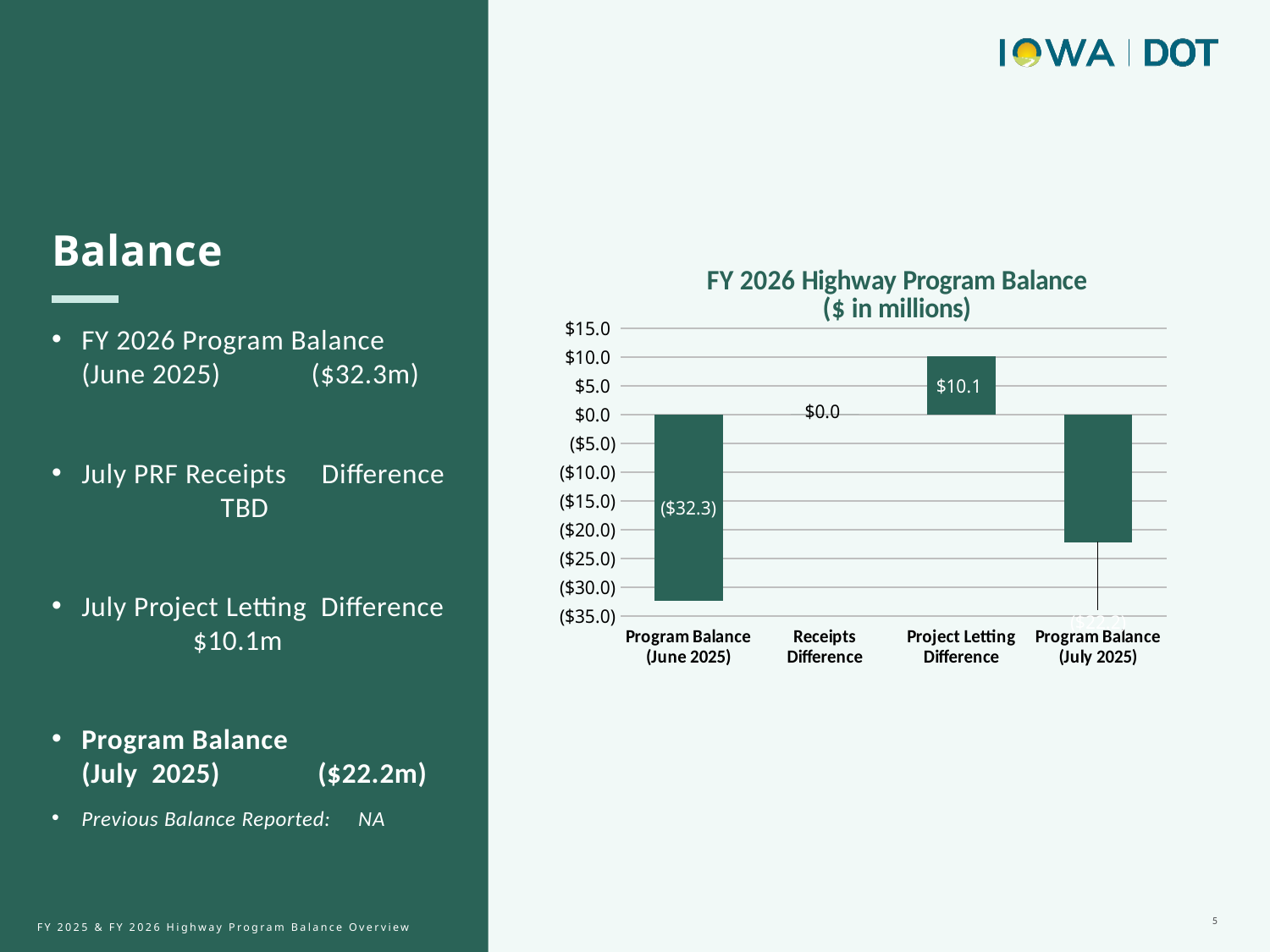
What is the difference between the value for Project Letting Difference and the value for Receipts Difference? $10.1 How many categories are shown on the x axis of the chart? 4 Is the value for Program Balance (July 2025) greater or less than ($15.0)? less In what units are the chart values expressed, according to the title? $ in millions Which category has the lowest value in the chart? Program Balance (June 2025) What is the value for Project Letting Difference in the chart? $10.1 What is the value for Program Balance (June 2025) in the FY 2026 Highway Program Balance chart? ($32.3) What is the value for Receipts Difference in the chart? $0.0 Which category has the highest value in the chart? Project Letting Difference What is the title of the chart? FY 2026 Highway Program Balance ($ in millions) Which is larger, the value for Project Letting Difference or the value for Receipts Difference? Project Letting Difference What kind of chart is shown on the slide? Bar chart